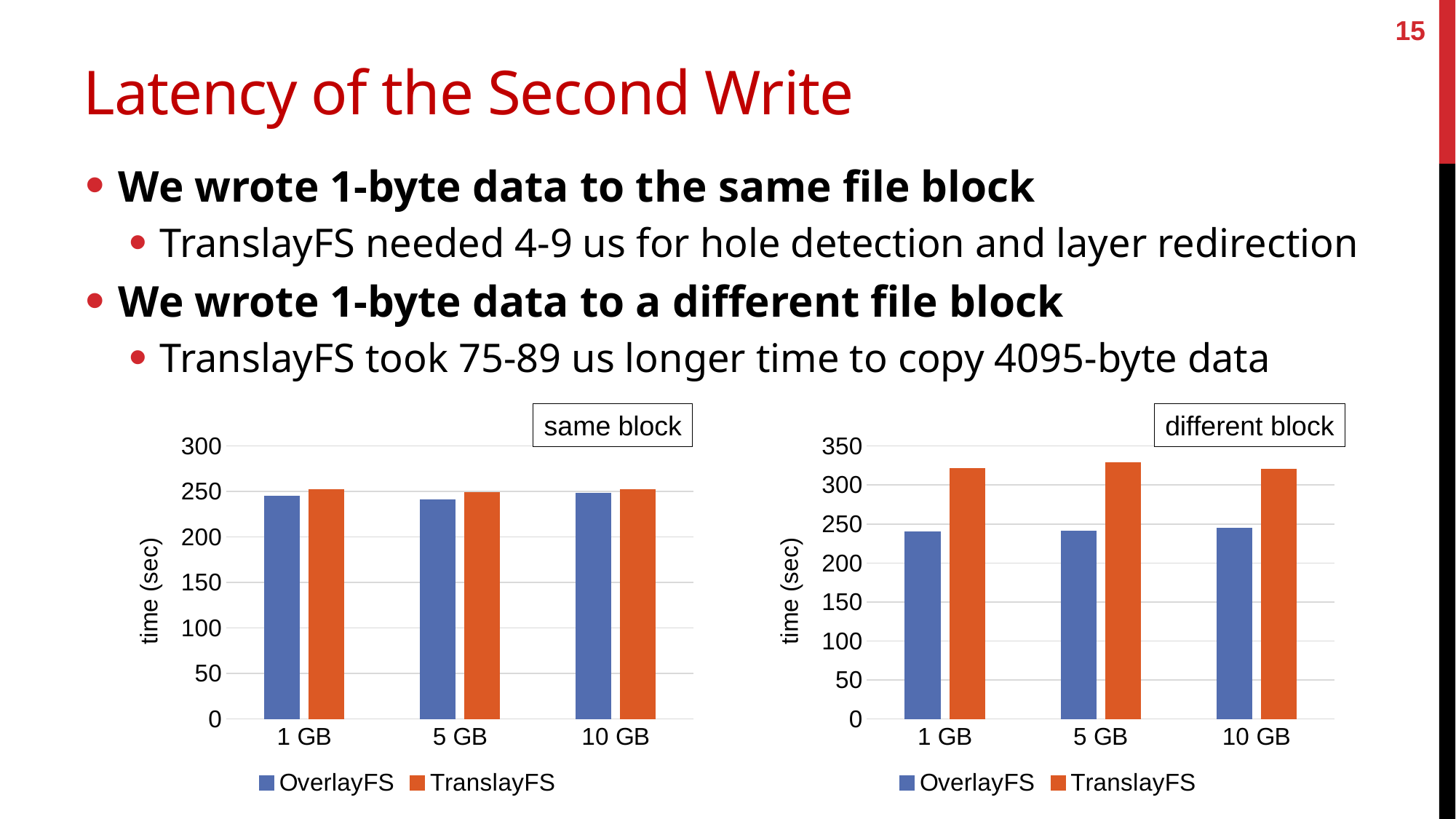
In the "different block" chart, is the value for OverlayFS at 10 GB greater or less than 200? greater In the "different block" chart, which is larger at 10 GB, OverlayFS or TranslayFS? TranslayFS In the "different block" chart, which is larger at 1 GB, OverlayFS or TranslayFS? TranslayFS In the "different block" chart, is the value for OverlayFS at 1 GB greater or less than 300? less What kind of chart is the "same block" chart? bar chart How many categories are shown on the x axis of the "same block" chart? 3 What is the y-axis label of the "same block" chart? time (sec) In the "same block" chart, is the value for OverlayFS at 5 GB greater or less than 200? greater Which series is shown in orange in the "different block" chart? TranslayFS How many series does the legend of the "different block" chart list? 2